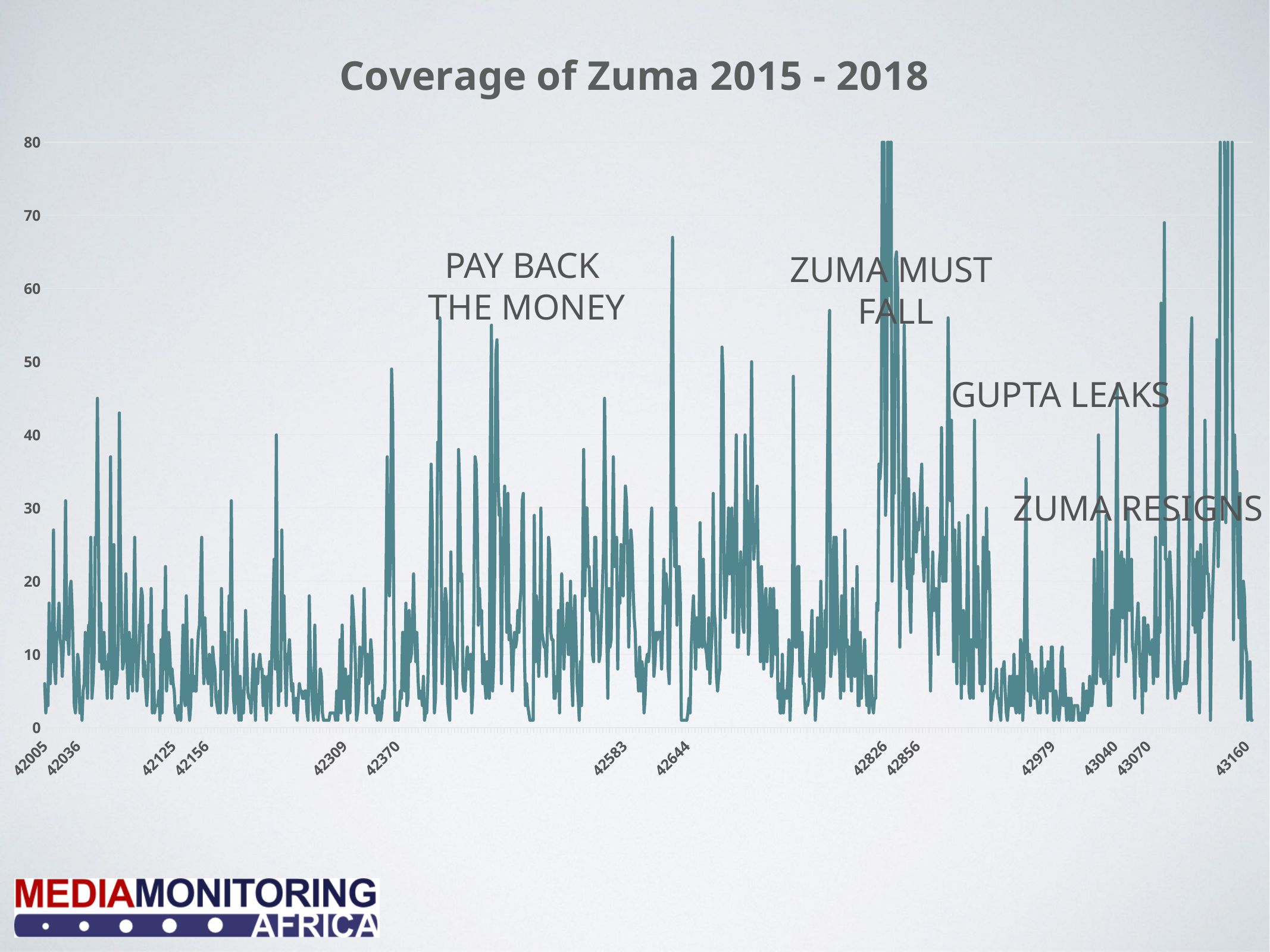
Which event label is placed next to the tallest spikes near x = 42826? ZUMA MUST FALL Is the peak of the line near x = 42370 greater or less than 40? greater Is the highest peak in the region labelled GUPTA LEAKS greater or less than 70? less Is the peak of the line near x = 42644 greater or less than 60? greater What is the highest value the line reaches on the vertical axis? 80 What kind of chart is shown on the slide? line chart What is the title of the chart? Coverage of Zuma 2015 - 2018